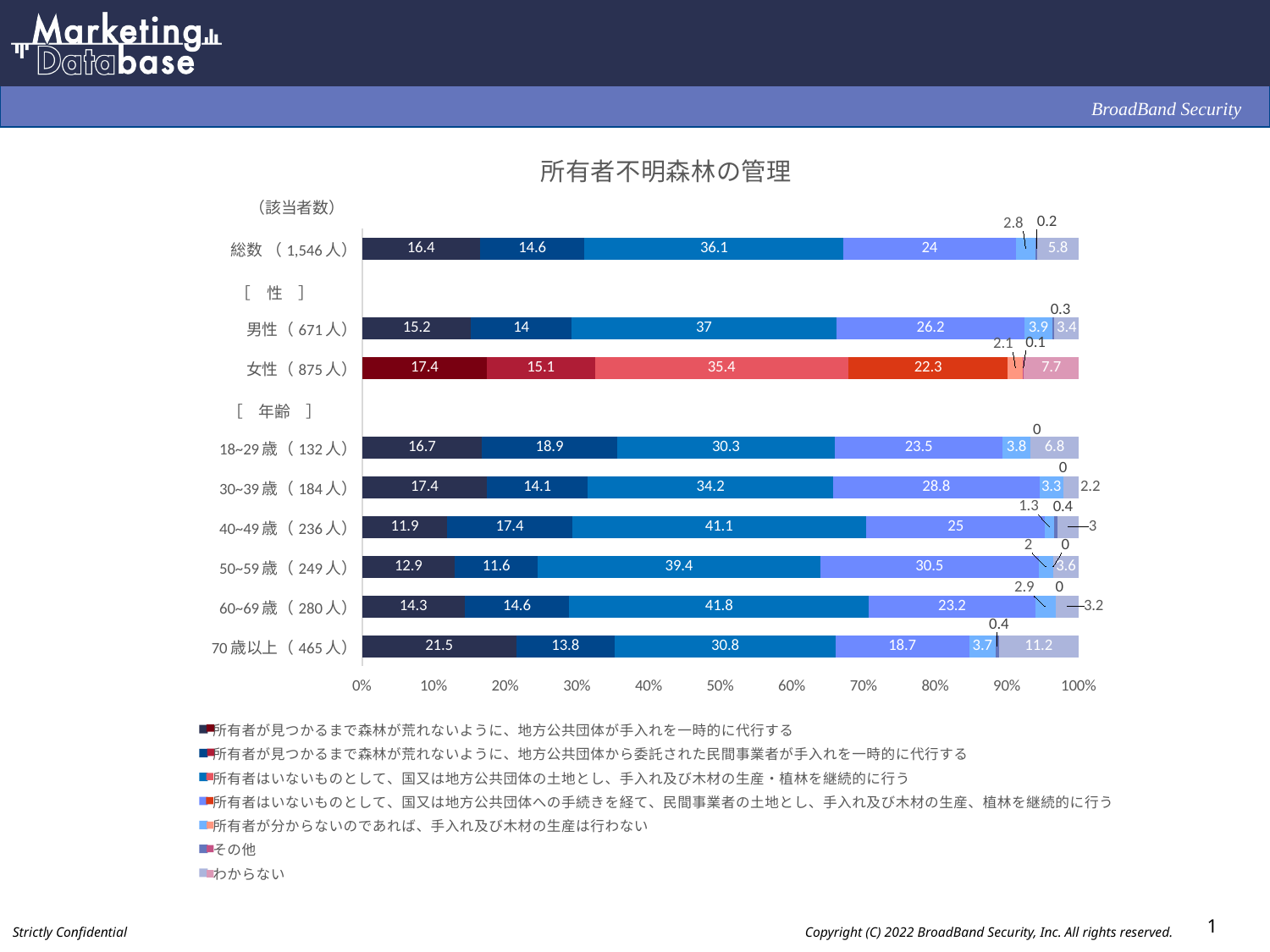
How many category bars are plotted in the chart? 9 What is the title of the chart? 所有者不明森林の管理 What kind of chart is shown on the slide? Stacked bar chart How many series does the legend list? 7 What is the value for 50~59歳 in the series 所有者が見つかるまで森林が荒れないように、地方公共団体から委託された民間事業者が手入れを一時的に代行する? 11.6 Which category has the highest value in the series 所有者はいないものとして、国又は地方公共団体の土地とし、手入れ及び木材の生産・植林を継続的に行う? 60~69歳 Which category has the highest value in the series 所有者が見つかるまで森林が荒れないように、地方公共団体が手入れを一時的に代行する? 70歳以上 Which category has the lowest value in the series 所有者が見つかるまで森林が荒れないように、地方公共団体が手入れを一時的に代行する? 40~49歳 What is the difference between 男性 and 女性 in the series 所有者はいないものとして、国又は地方公共団体の土地とし、手入れ及び木材の生産・植林を継続的に行う? 1.6 What is the value for 70歳以上 in the わからない series? 11.2 Which is larger in the series 所有者はいないものとして、国又は地方公共団体への手続きを経て、民間事業者の土地とし、手入れ及び木材の生産、植林を継続的に行う: 30~39歳 or 60~69歳? 30~39歳 What is the value for 総数 in the series 所有者が見つかるまで森林が荒れないように、地方公共団体が手入れを一時的に代行する? 16.4